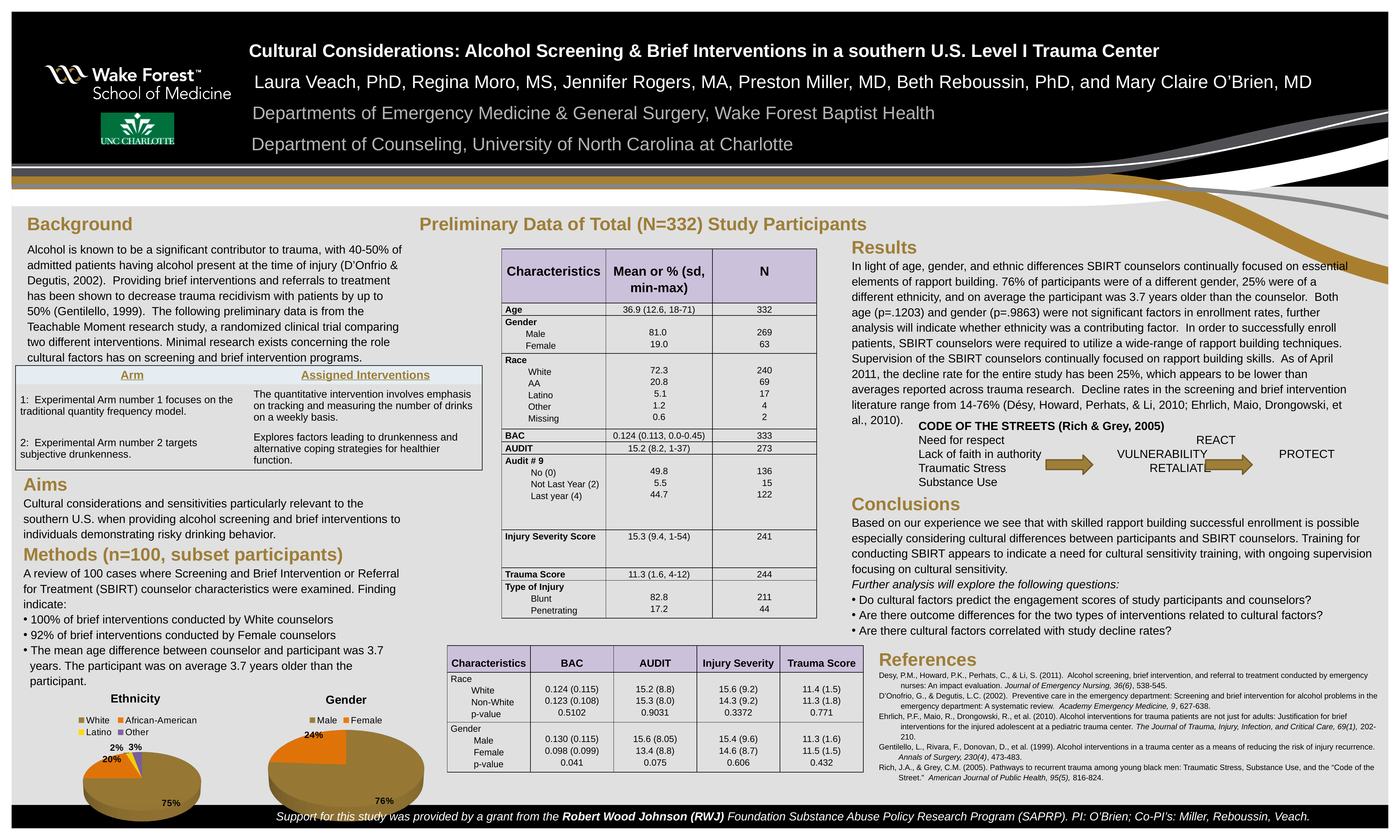
In the Gender pie chart, which is larger, Male or Female? Male In the Ethnicity pie chart, what is the difference between the White and African-American shares? 55% In the Ethnicity pie chart, what share is labelled for African-American? 20% In the Ethnicity pie chart, which category has the largest slice? White In the Ethnicity pie chart, what share is labelled for Latino? 2% In the Ethnicity pie chart, how many categories does the legend list? 4 In the Ethnicity pie chart, which category has the smallest slice? Latino In the Gender pie chart, what share is labelled for Male? 76% In the Ethnicity pie chart, what share is labelled for White? 75% In the Ethnicity pie chart, what share is labelled for Other? 3% In the Gender pie chart, what share is labelled for Female? 24% What type of chart is the Gender chart? Pie chart